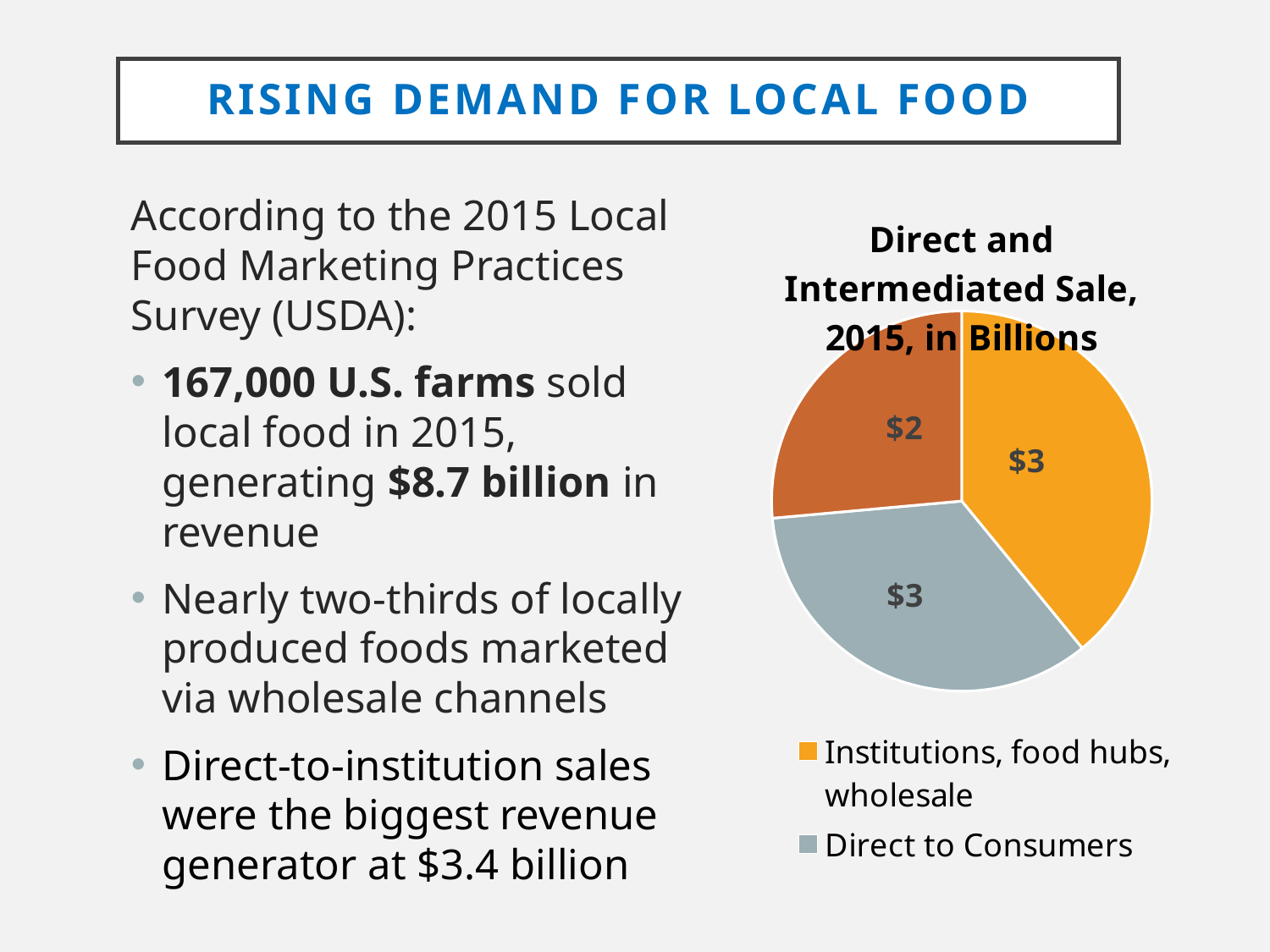
What is the title of the pie chart? Direct and Intermediated Sale, 2015, in Billions How many entries does the pie chart's legend list? 2 What kind of chart is shown on the slide? pie chart How many slices does the pie chart have? 3 What is the value printed on the smallest slice of the pie chart? $2 Which colour represents Direct to Consumers in the pie chart? gray What is the value shown for the Institutions, food hubs, wholesale slice of the pie chart? $3 What is the value shown for the Direct to Consumers slice of the pie chart? $3